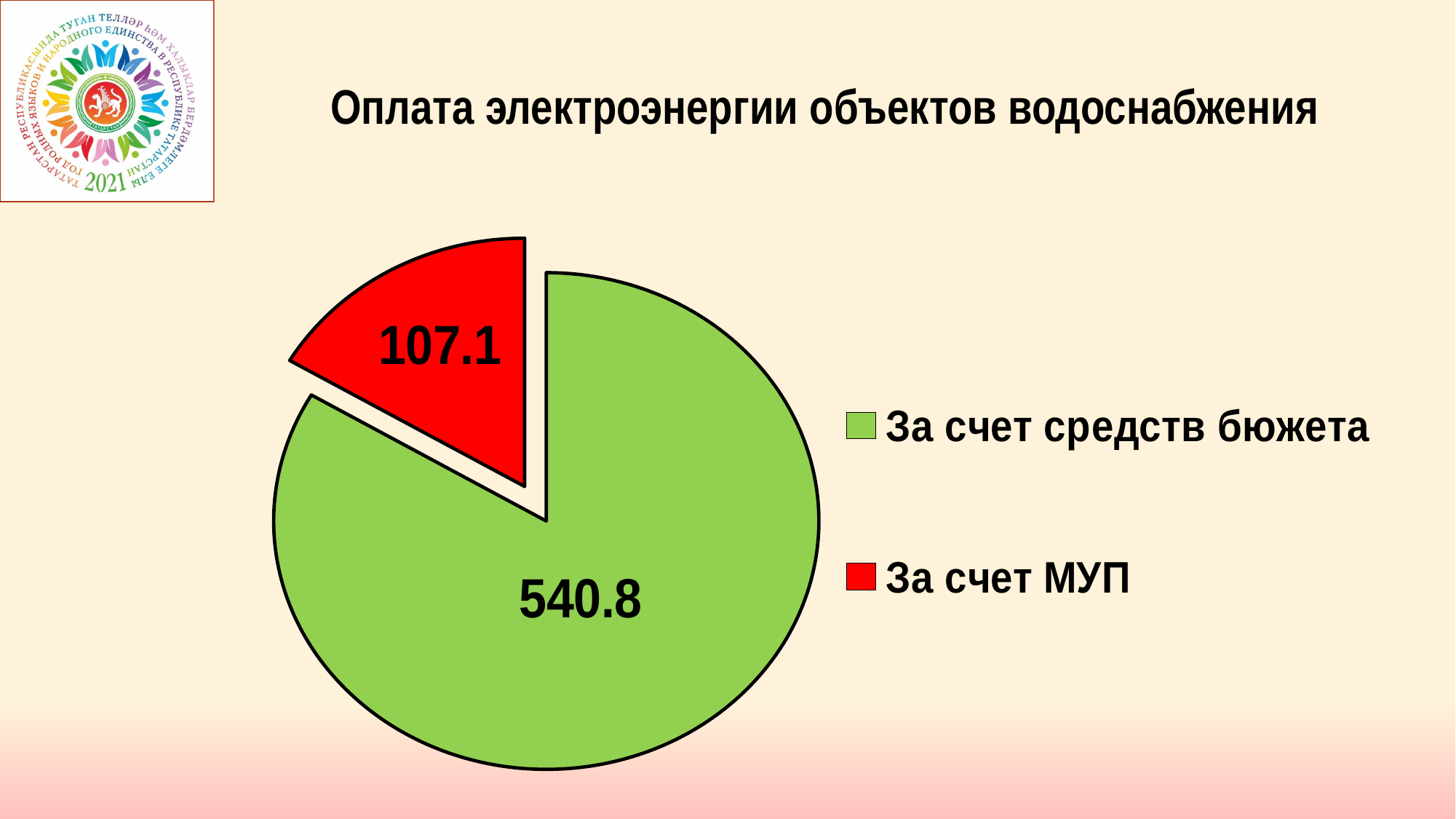
How many slices does the pie chart have? 2 What is the difference between the values for "За счет средств бюжета" and "За счет МУП"? 433.7 What colour is the slice for "За счет МУП"? Red What value is shown for the slice "За счет средств бюжета"? 540.8 What value is shown for the slice "За счет МУП"? 107.1 Which is larger: the value for "За счет средств бюжета" or the value for "За счет МУП"? За счет средств бюжета Which category has the largest slice of the pie? За счет средств бюжета What kind of chart is shown on the slide? Pie chart Which category has the smallest slice of the pie? За счет МУП How many entries does the legend list? 2 What is the total of the two values shown in the pie chart? 647.9 What is the title of the chart? Оплата электроэнергии объектов водоснабжения